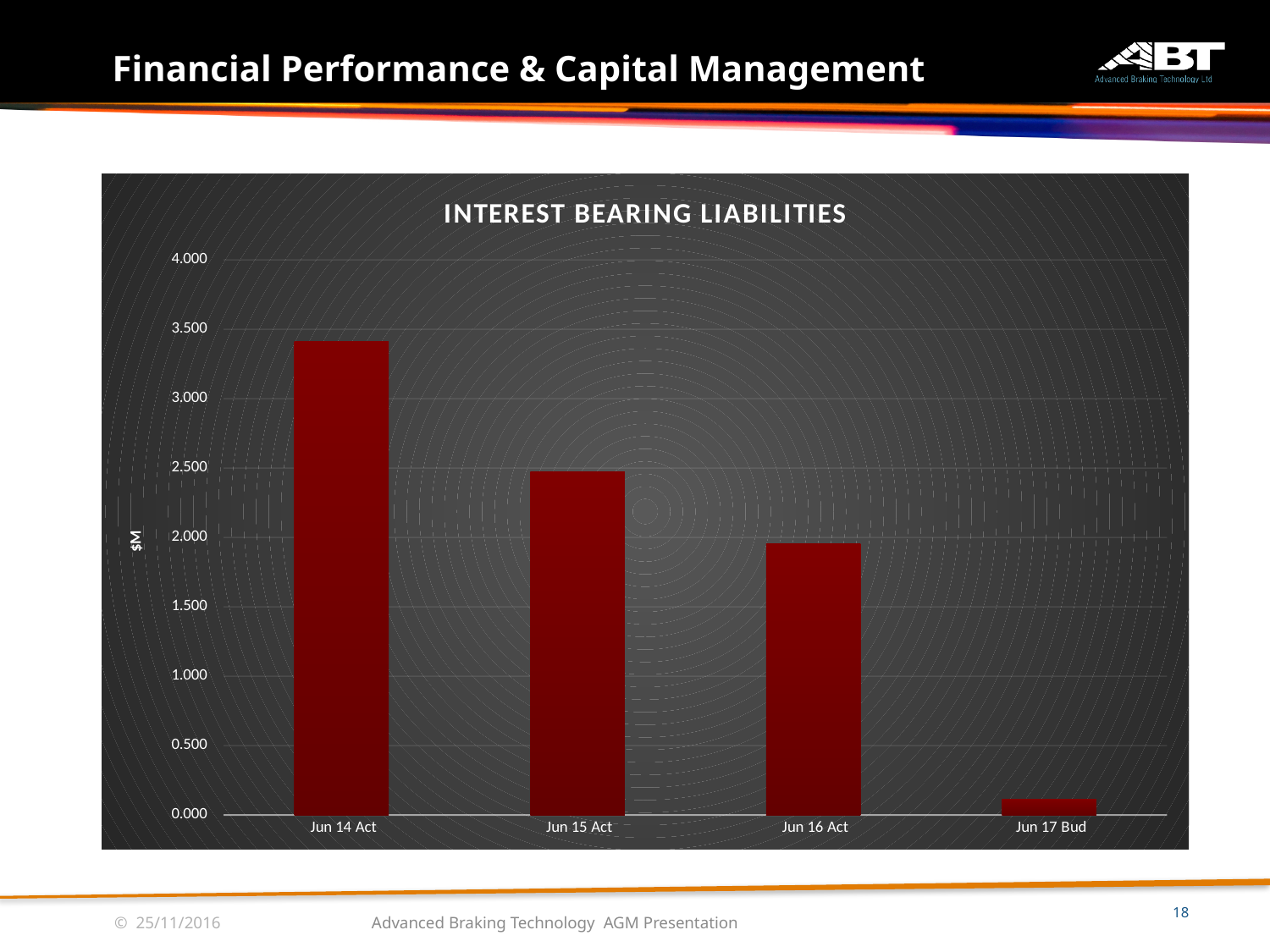
Is the value for Jun 14 Act greater or less than 3.000? greater Is the value for Jun 16 Act greater or less than 1.500? greater Is the value for Jun 15 Act greater or less than 2.000? greater Do the values rise or fall from Jun 14 Act to Jun 17 Bud? fall How many categories are shown on the x axis of the chart? 4 What unit is shown on the y axis label of the chart? $M Which category has the lowest interest bearing liabilities? Jun 17 Bud What type of chart is shown on the slide? bar chart Which category has the highest interest bearing liabilities? Jun 14 Act What is the title of the chart? INTEREST BEARING LIABILITIES Which is larger, the value for Jun 15 Act or the value for Jun 16 Act? Jun 15 Act